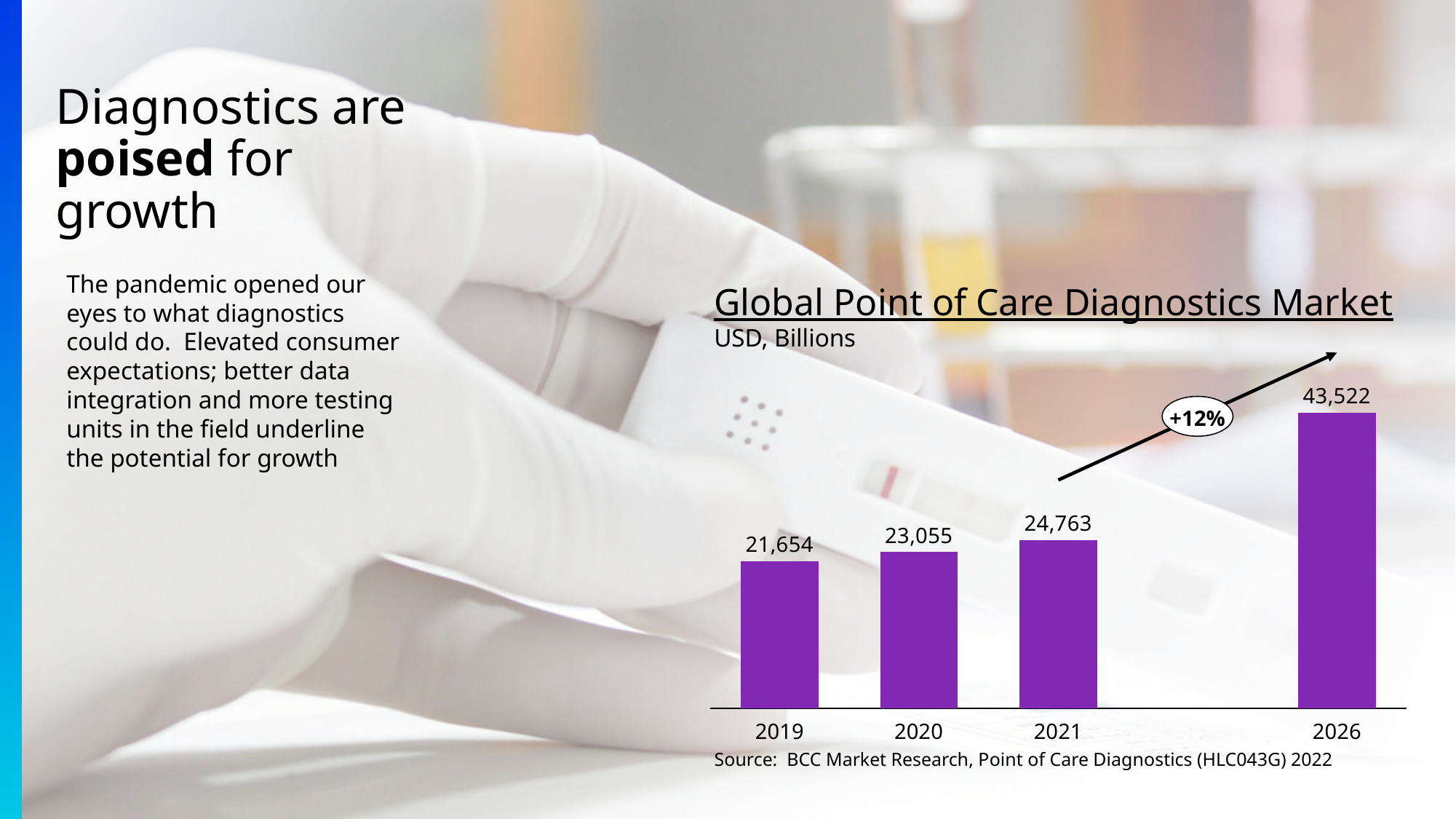
What is the difference between the values for 2026 and 2021? 18,759 Which is larger, the value for 2021 or the value for 2020? 2021 Do the values rise or fall from 2019 to 2026? Rise What kind of chart is shown? Bar chart What is the value for 2019? 21,654 What is the value for 2026? 43,522 Which year has the lowest value? 2019 How many years are shown on the chart? 4 Which year has the highest value? 2026 What is the value for 2020? 23,055 What is the value for 2021? 24,763 What is the difference between the values for 2020 and 2019? 1,401